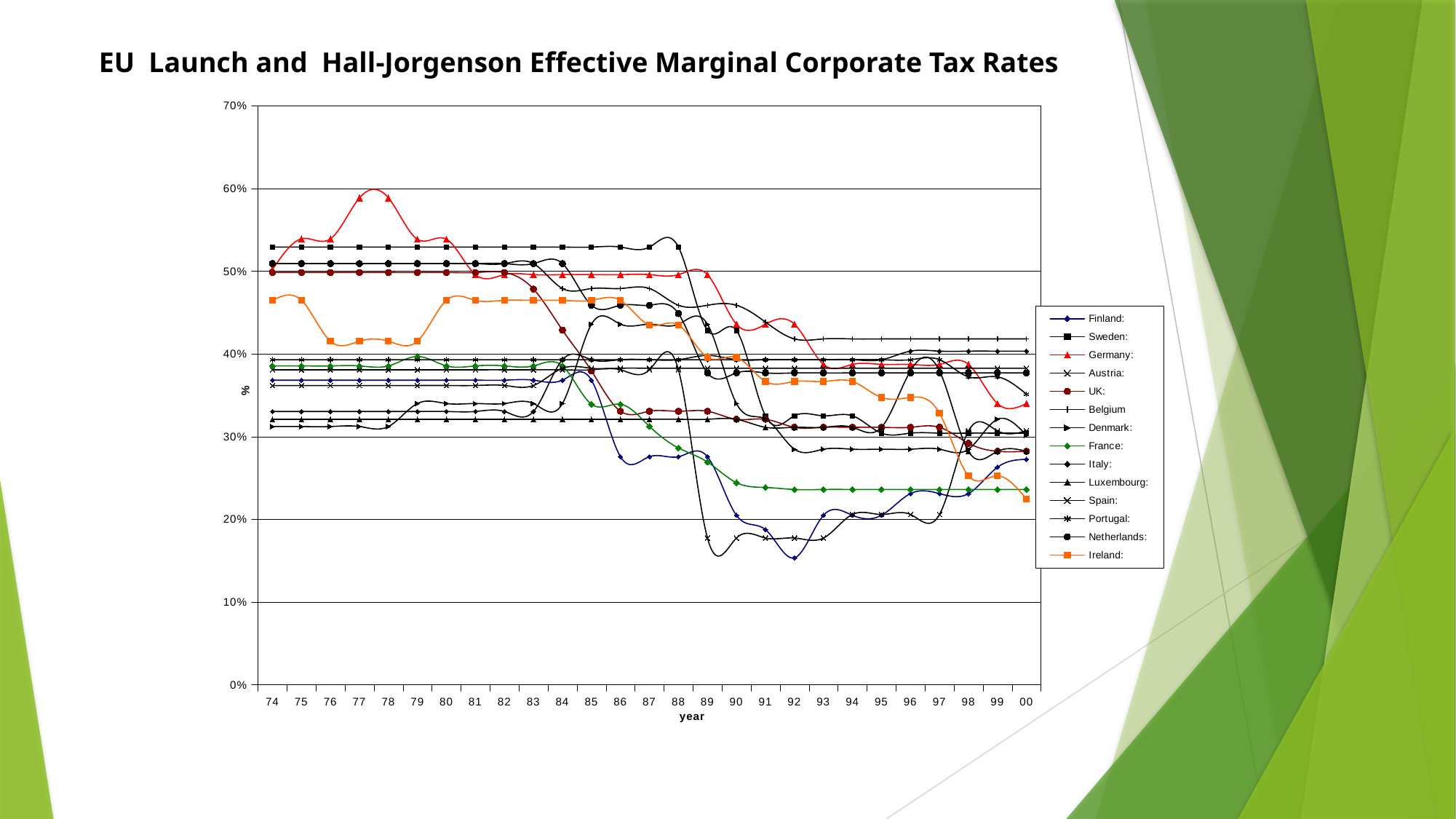
Which series has the highest value in 77? Germany Does the value for Germany rise or fall overall from 74 to 00? fall What kind of chart is shown on the slide? line chart Is the value for Sweden in 74 greater or less than 50%? greater Is the value for Finland in 92 greater or less than 20%? less Is the value for France in 95 greater or less than 30%? less What is the title of the chart? EU Launch and Hall-Jorgenson Effective Marginal Corporate Tax Rates What is the label of the x axis? year In 74, which is larger, the value for Sweden or the value for Finland? Sweden How many series does the legend list? 14 How many years are shown along the x axis? 27